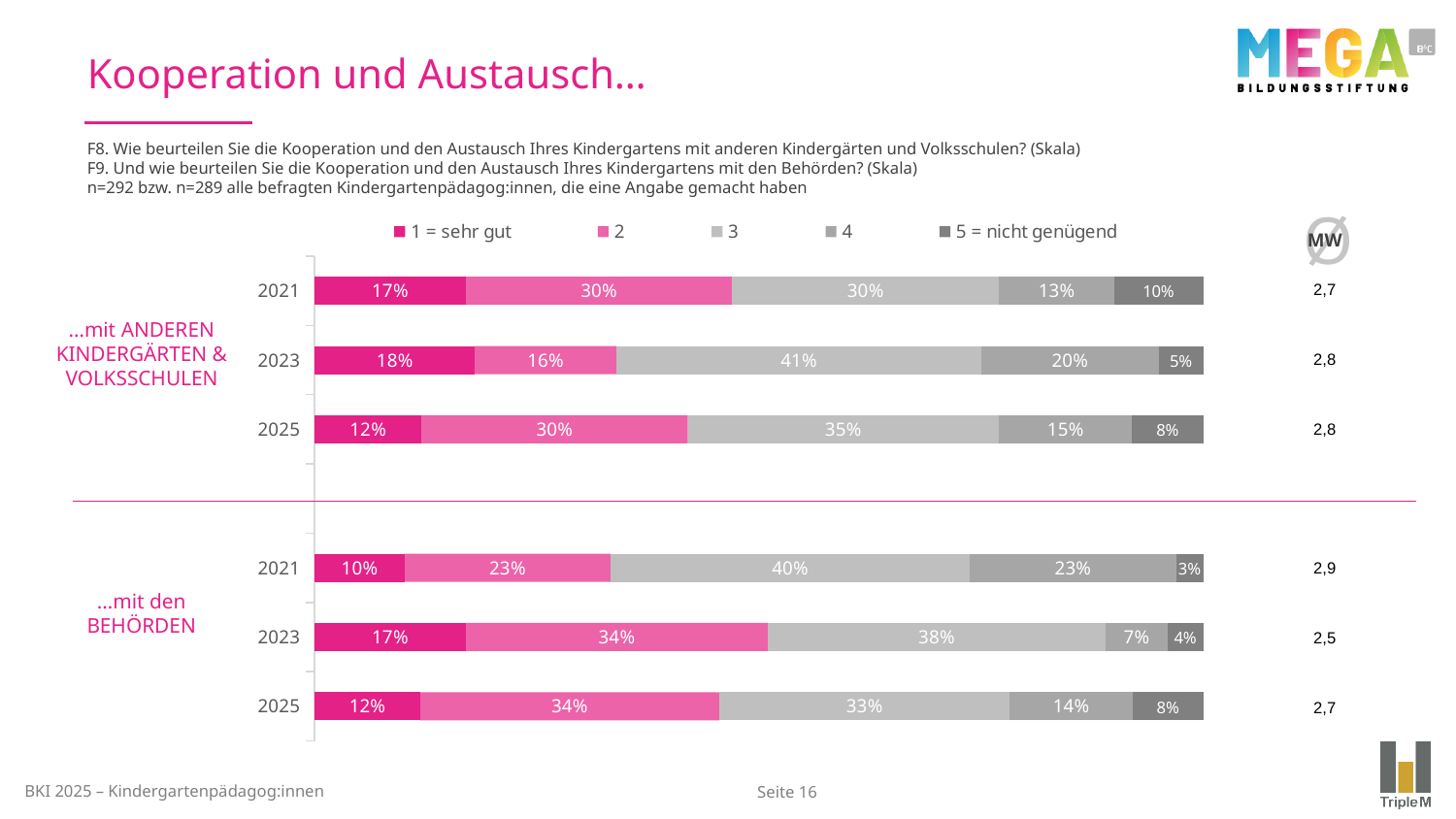
In the chart '...mit ANDEREN KINDERGÄRTEN & VOLKSSCHULEN', what is the difference between the '2' share in 2021 and in 2023? 14 percentage points In the chart '...mit den BEHÖRDEN', what percentage answered '3' in 2021? 40% In the chart '...mit den BEHÖRDEN', what percentage answered '5 = nicht genügend' in 2025? 8% How many years are shown in the chart '...mit den BEHÖRDEN'? 3 What is the MW (mean) value shown for 2023 in the chart '...mit den BEHÖRDEN'? 2,5 In the chart '...mit den BEHÖRDEN', which year has the lowest share of '1 = sehr gut' answers? 2021 What kind of chart is used on this slide? Stacked bar chart In the chart '...mit ANDEREN KINDERGÄRTEN & VOLKSSCHULEN', what is the combined share of '1 = sehr gut' and '2' in 2025? 42% In the chart '...mit ANDEREN KINDERGÄRTEN & VOLKSSCHULEN', which year has the highest share of '3' answers? 2023 In the chart '...mit ANDEREN KINDERGÄRTEN & VOLKSSCHULEN', what percentage answered '1 = sehr gut' in 2023? 18% In the chart '...mit den BEHÖRDEN', is the '4' share larger in 2021 or in 2023? 2021 How many series does the legend list? 5